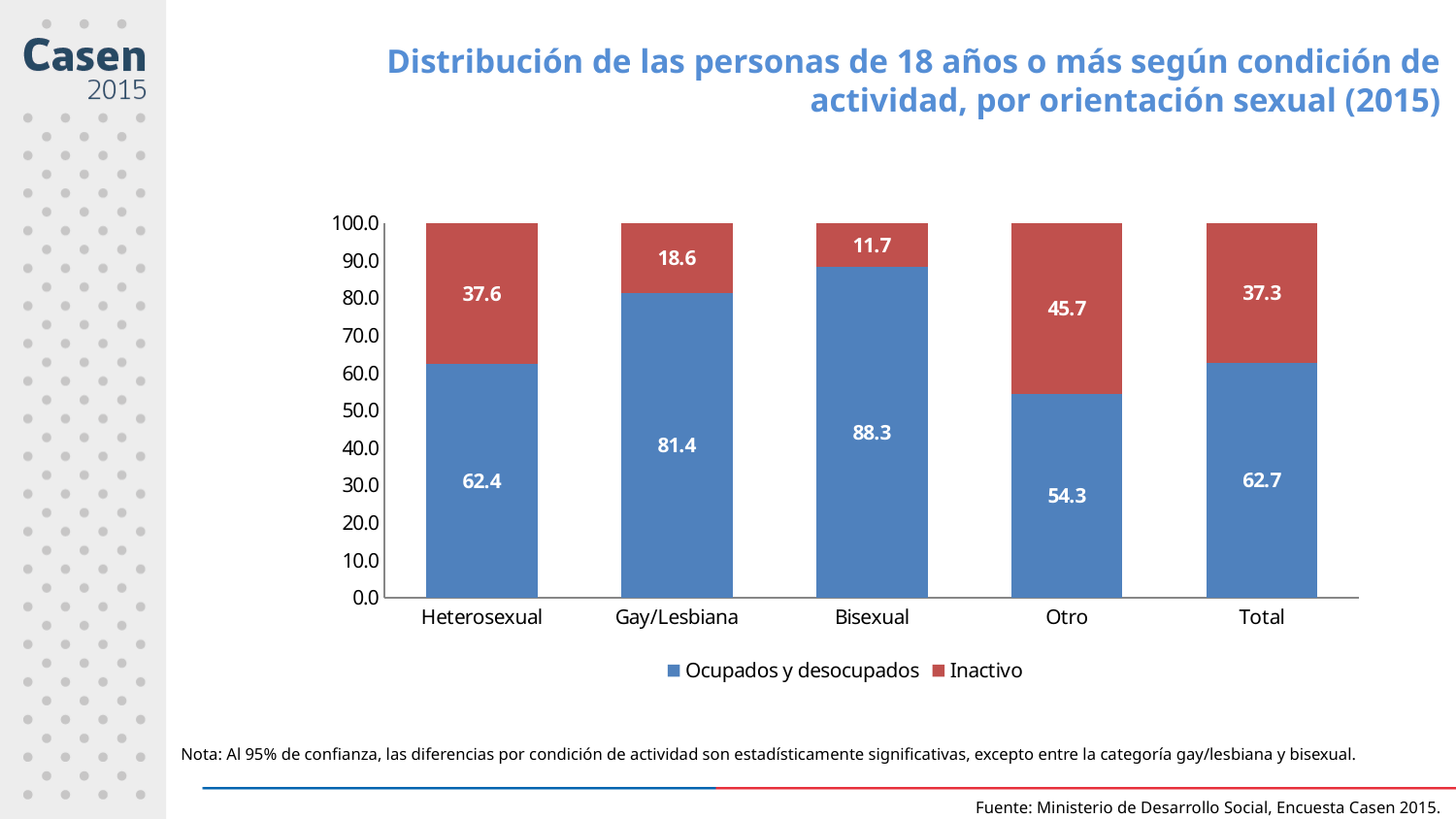
What is the value for Inactivo in the Otro category? 45.7 What is the difference between the Inactivo values for Heterosexual and Gay/Lesbiana? 19.0 How many categories are shown on the x axis? 5 Which is larger: the Ocupados y desocupados value for Otro or for Heterosexual? Heterosexual What is the total of the stacked bar for Otro? 100.0 What is the value for Ocupados y desocupados in the Total category? 62.7 How many series does the legend list? 2 Is the Ocupados y desocupados value for Gay/Lesbiana greater or less than 80.0? greater What is the value for Ocupados y desocupados in the Bisexual category? 88.3 Which category has the highest value for Ocupados y desocupados? Bisexual What kind of chart is shown on the slide? Stacked bar chart Which category has the lowest value for Inactivo? Bisexual